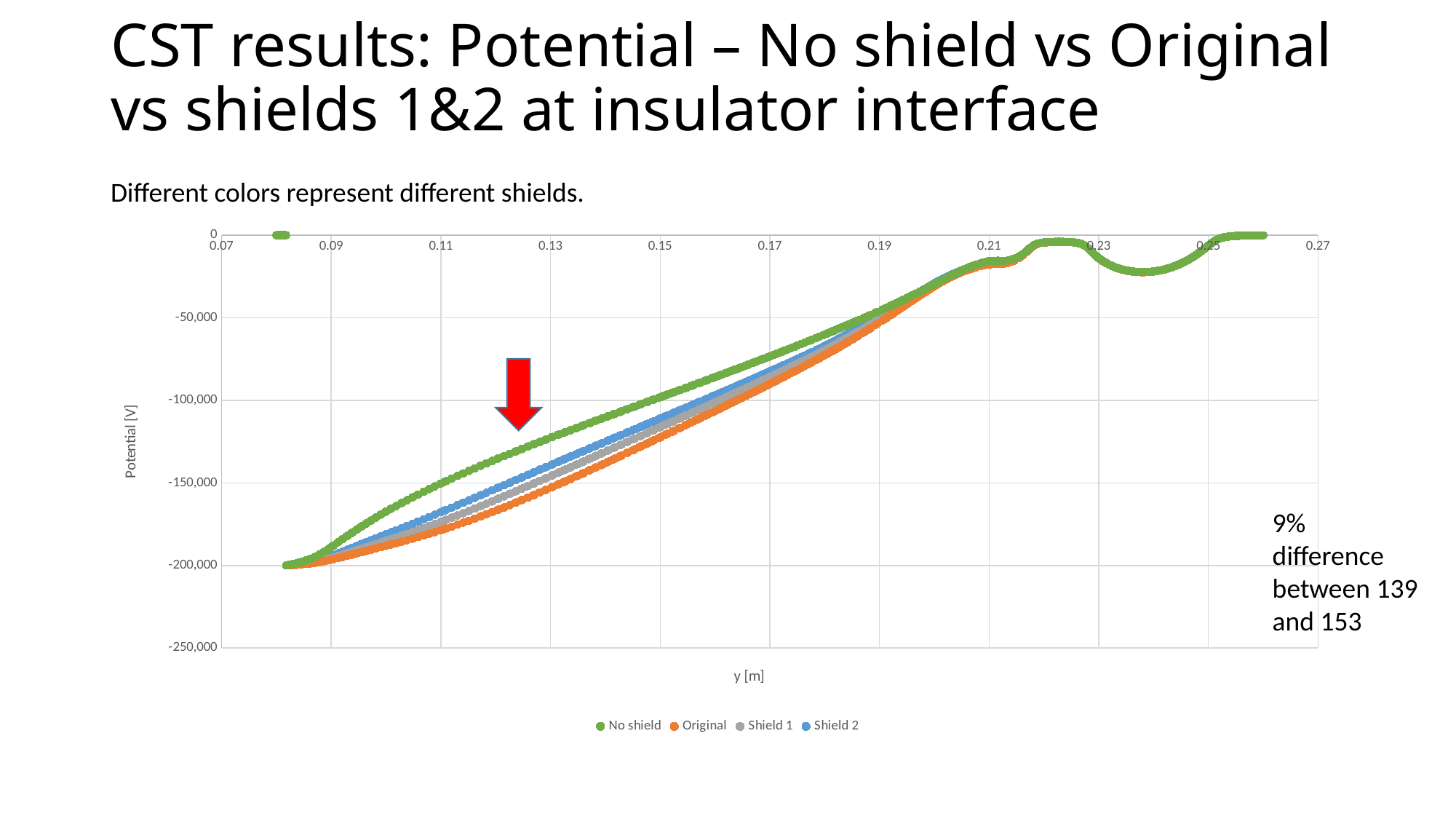
What are the series names listed in the legend? No shield, Original, Shield 1, Shield 2 At y = 0.13 m, which series has the lowest (most negative) potential? Original Is the No shield potential at y = 0.17 m greater or less than -100,000? greater What kind of chart is shown on the slide? line chart Is the Original potential at y = 0.11 m greater or less than -150,000? less At y = 0.13 m, which series has the higher potential, Shield 2 or Original? Shield 2 Is the No shield potential at y = 0.13 m greater or less than -100,000? less At y = 0.13 m, which series has the higher potential, No shield or Original? No shield How many series does the legend list? 4 What is the label of the vertical axis? Potential [V] Do the potential values rise or fall as y [m] increases from 0.09 to 0.21? rise At y = 0.13 m, which series has the highest (least negative) potential? No shield